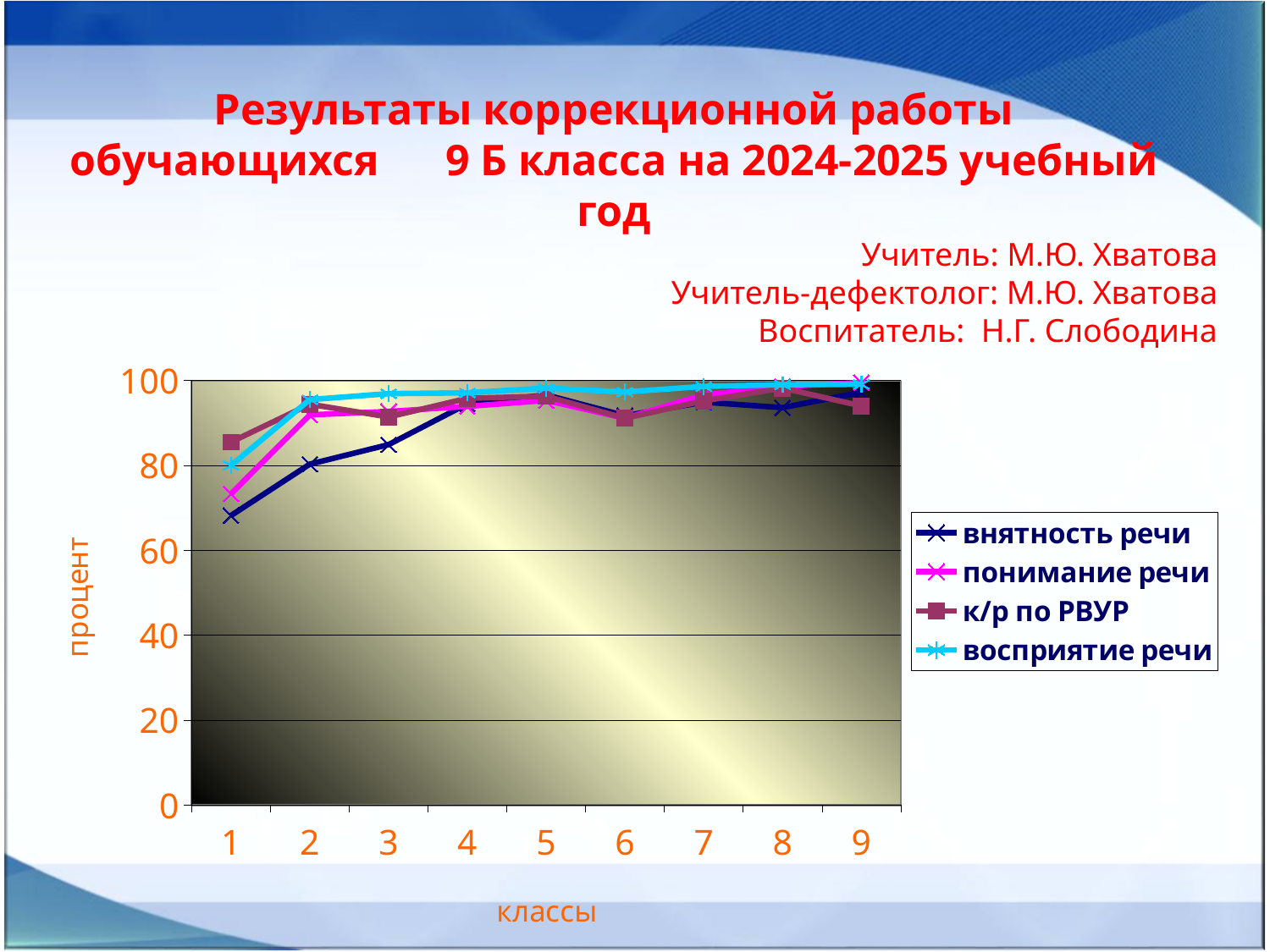
Does the внятность речи line rise or fall from class 1 to class 9? rises Which series has the lowest value at class 1? внятность речи Is the value for понимание речи at class 1 greater or less than 60? greater What kind of chart is shown on the slide? line chart Is the value for внятность речи at class 9 greater or less than 80? greater Which series has the highest value at class 1? к/р по РВУР What is the title of the vertical axis? процент At class 3, which is higher: внятность речи or восприятие речи? восприятие речи Is the value for внятность речи at class 1 greater or less than 80? less How many classes (categories) are plotted along the x axis? 9 How many series does the legend list? 4